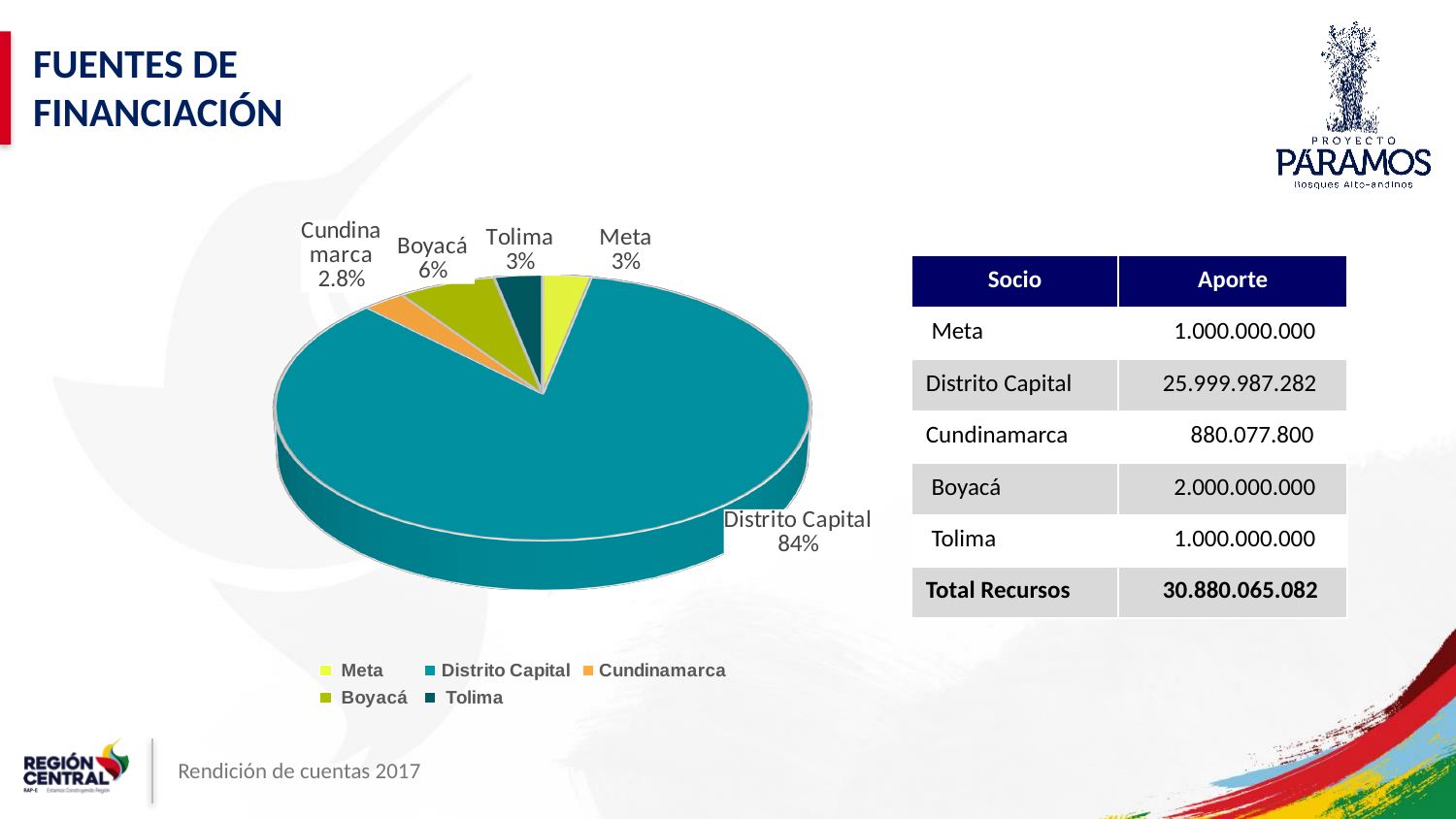
Which category has the smallest slice of the pie? Cundinamarca What kind of chart is shown on the slide? Pie chart Which category has the largest slice of the pie? Distrito Capital What share of the pie does Boyacá hold? 6% What share of the pie does Distrito Capital hold? 84% What is the difference in percentage points between the Distrito Capital slice and the Boyacá slice? 78 How many slices does the pie chart have? 5 Which slice is larger, Boyacá or Tolima? Boyacá How many entries does the chart legend list? 5 What share of the pie does Cundinamarca hold? 2.8%